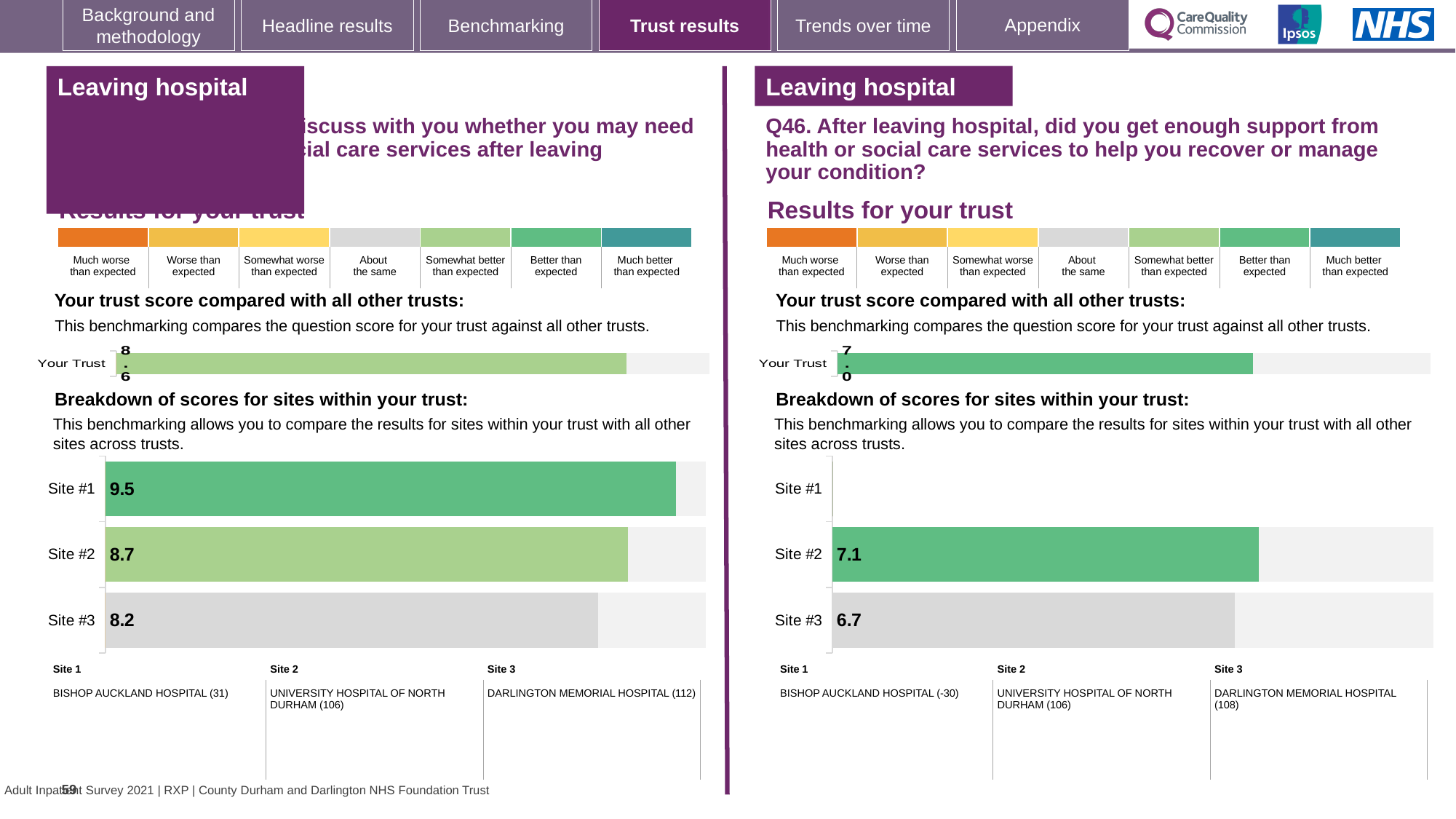
On the left-hand 'Your Trust' chart, what is the trust score shown? 8.6 On the left-hand site breakdown chart, what is the difference between the scores for Site #1 and Site #3? 1.3 On the left-hand site breakdown chart, which site has the highest score? Site #1 On the left-hand site breakdown chart, what is the score for Site #3? 8.2 On the right-hand (Q46) 'Your Trust' chart, what is the trust score shown? 7.0 On the left-hand site breakdown chart, which site has the lowest score? Site #3 On the right-hand (Q46) site breakdown chart, what is the difference between the scores for Site #2 and Site #3? 0.4 On the left-hand site breakdown chart, what is the score for Site #1? 9.5 What type of chart is used for the site breakdown of scores on the right-hand (Q46) side? Bar chart On the right-hand (Q46) site breakdown chart, what is the score for Site #2? 7.1 On the left-hand site breakdown chart, which is larger, the score for Site #2 or Site #3? Site #2 On the right-hand (Q46) site breakdown chart, what is the score for Site #3? 6.7